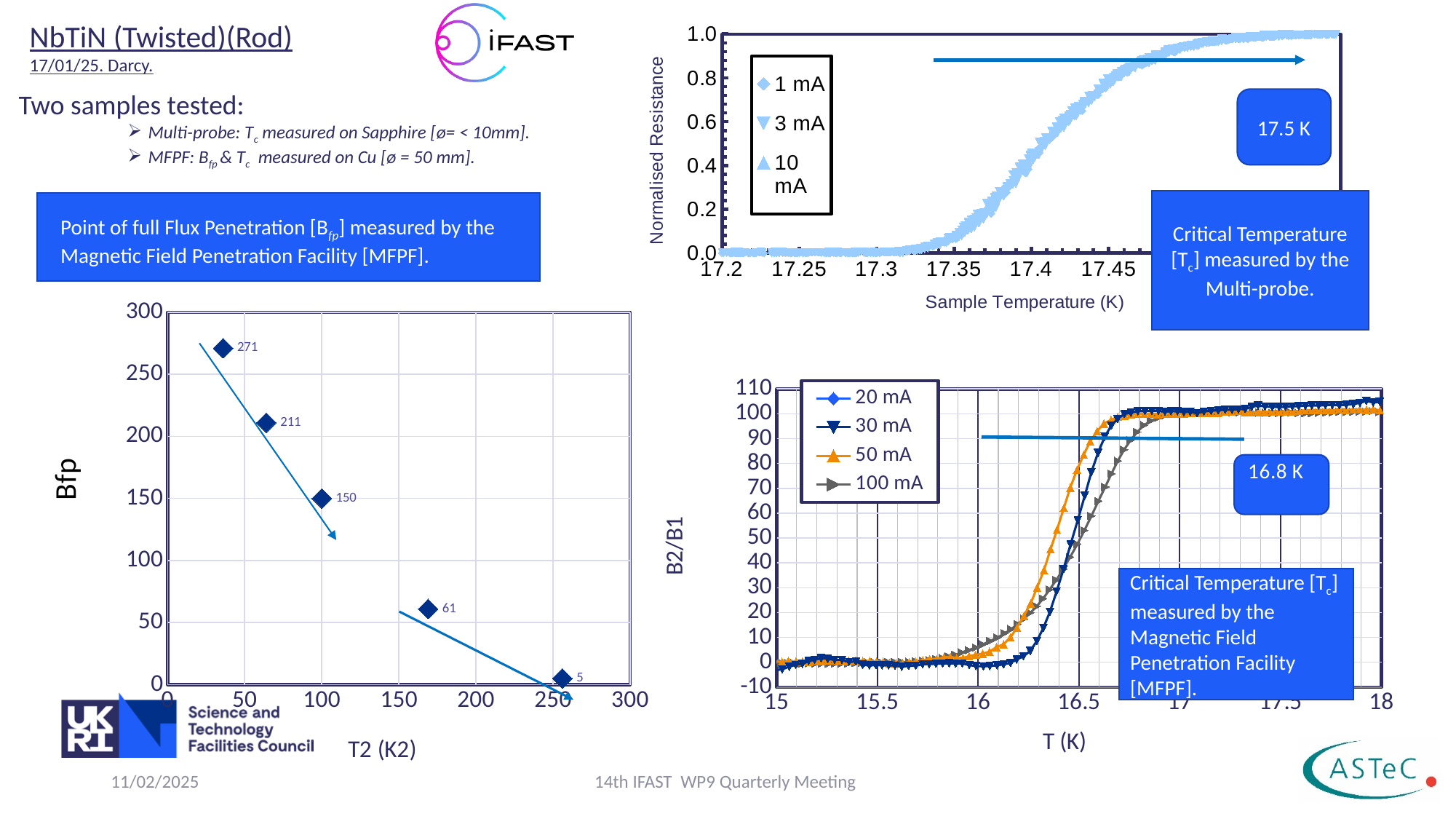
In the bottom-left chart (Bfp vs T2), how many data points are plotted? 5 In the top-right chart, does the normalised resistance rise or fall as sample temperature increases? rise In the top-right chart (Normalised Resistance vs Sample Temperature), is the normalised resistance at 17.3 K greater or less than 0.2? less In the bottom-right chart (B2/B1 vs T), is the B2/B1 value at 17 K greater or less than 90? greater In the bottom-left chart (Bfp vs T2), what is the lowest Bfp value plotted? 5 What kind of chart is the bottom-left chart (Bfp vs T2)? scatter chart In the bottom-right chart (B2/B1 vs T), how many series does the legend list? 4 In the bottom-right chart (B2/B1 vs T), what are the legend entries? 20 mA, 30 mA, 50 mA, 100 mA In the bottom-left chart (Bfp vs T2), do the Bfp values rise or fall as T2 increases? fall In the bottom-left chart (Bfp vs T2), what is the highest Bfp value plotted? 271 In the top-right chart (Normalised Resistance vs Sample Temperature), how many series does the legend list? 3 In the bottom-left chart (Bfp vs T2), what is the difference between the two highest labelled values, 271 and 211? 60